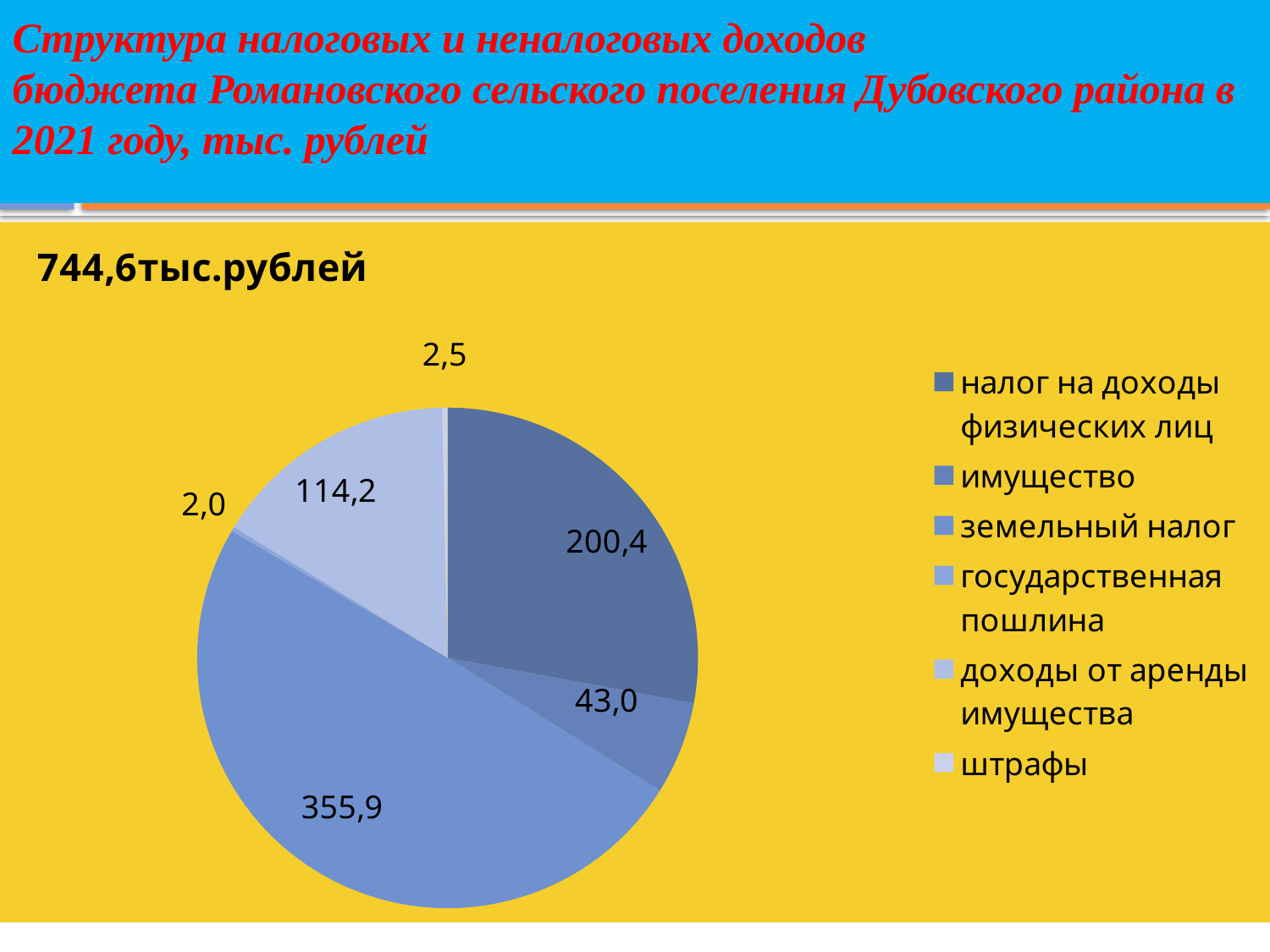
How many categories are shown in the pie chart? 6 What type of chart is shown on the slide? pie chart Which is larger: the value for доходы от аренды имущества or the value for имущество? доходы от аренды имущества What is the difference between the values for земельный налог and налог на доходы физических лиц? 155,5 Which category has the largest slice of the pie? земельный налог What is the value for штрафы? 2,5 Which category has the smallest slice of the pie? государственная пошлина What is the value for налог на доходы физических лиц? 200,4 What total amount in тыс. рублей is printed above the chart? 744,6тыс.рублей What is the value for доходы от аренды имущества? 114,2 What is the value for имущество? 43,0 What is the value for земельный налог? 355,9